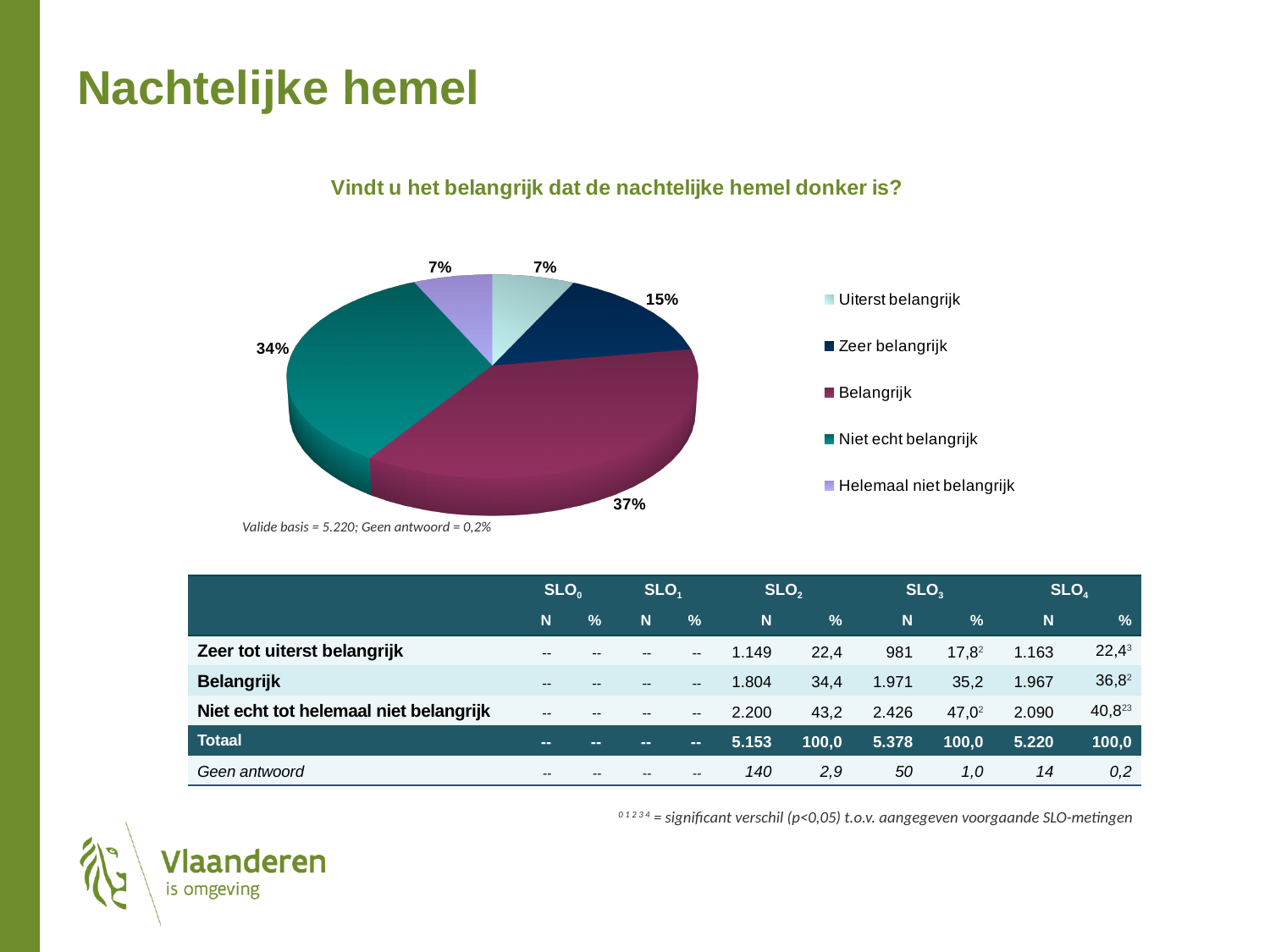
What is the share for 'Niet echt belangrijk' in the pie chart? 34% Which is larger in the pie chart: 'Zeer belangrijk' or 'Niet echt belangrijk'? Niet echt belangrijk How many entries does the legend of the pie chart list? 5 What is the difference in percentage points between 'Belangrijk' and 'Niet echt belangrijk' in the pie chart? 3 What is the title of the pie chart? Vindt u het belangrijk dat de nachtelijke hemel donker is? What is the share for 'Uiterst belangrijk' in the pie chart? 7% What is the share for 'Belangrijk' in the pie chart? 37% What kind of chart is shown on the slide? pie chart What is the share for 'Helemaal niet belangrijk' in the pie chart? 7% What is the share for 'Zeer belangrijk' in the pie chart? 15% How many slices does the pie chart have? 5 Which category has the largest slice in the pie chart? Belangrijk